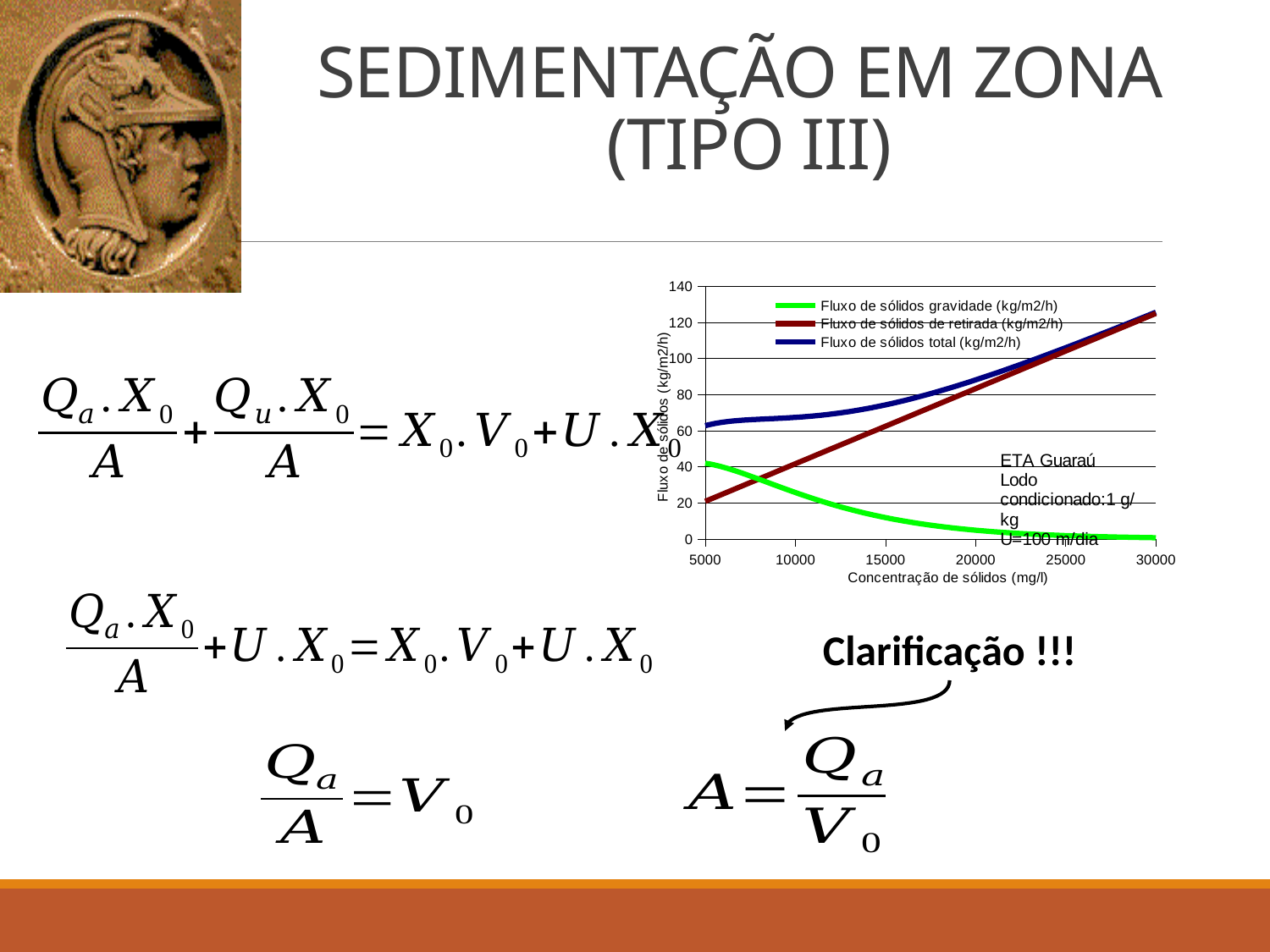
Which colour is used for the 'Fluxo de sólidos gravidade (kg/m2/h)' series? green Does the 'Fluxo de sólidos gravidade (kg/m2/h)' series rise or fall as the concentration increases along the x axis? fall At a concentration of 25000 mg/l, which is larger: 'Fluxo de sólidos de retirada (kg/m2/h)' or 'Fluxo de sólidos gravidade (kg/m2/h)'? Fluxo de sólidos de retirada (kg/m2/h) Does the 'Fluxo de sólidos de retirada (kg/m2/h)' series rise or fall as the concentration increases along the x axis? rise Is the value of 'Fluxo de sólidos total (kg/m2/h)' at a concentration of 30000 mg/l greater or less than 100? greater Does the 'Fluxo de sólidos total (kg/m2/h)' series rise or fall along the x axis? rise At a concentration of 10000 mg/l, which is larger: 'Fluxo de sólidos total (kg/m2/h)' or 'Fluxo de sólidos de retirada (kg/m2/h)'? Fluxo de sólidos total (kg/m2/h) What is the label of the x axis of the chart? Concentração de sólidos (mg/l) Is the value of 'Fluxo de sólidos total (kg/m2/h)' at a concentration of 5000 mg/l greater or less than 40? greater How many series does the chart legend list? 3 What kind of chart is shown on the slide? line chart Is the value of 'Fluxo de sólidos gravidade (kg/m2/h)' at a concentration of 30000 mg/l greater or less than 20? less